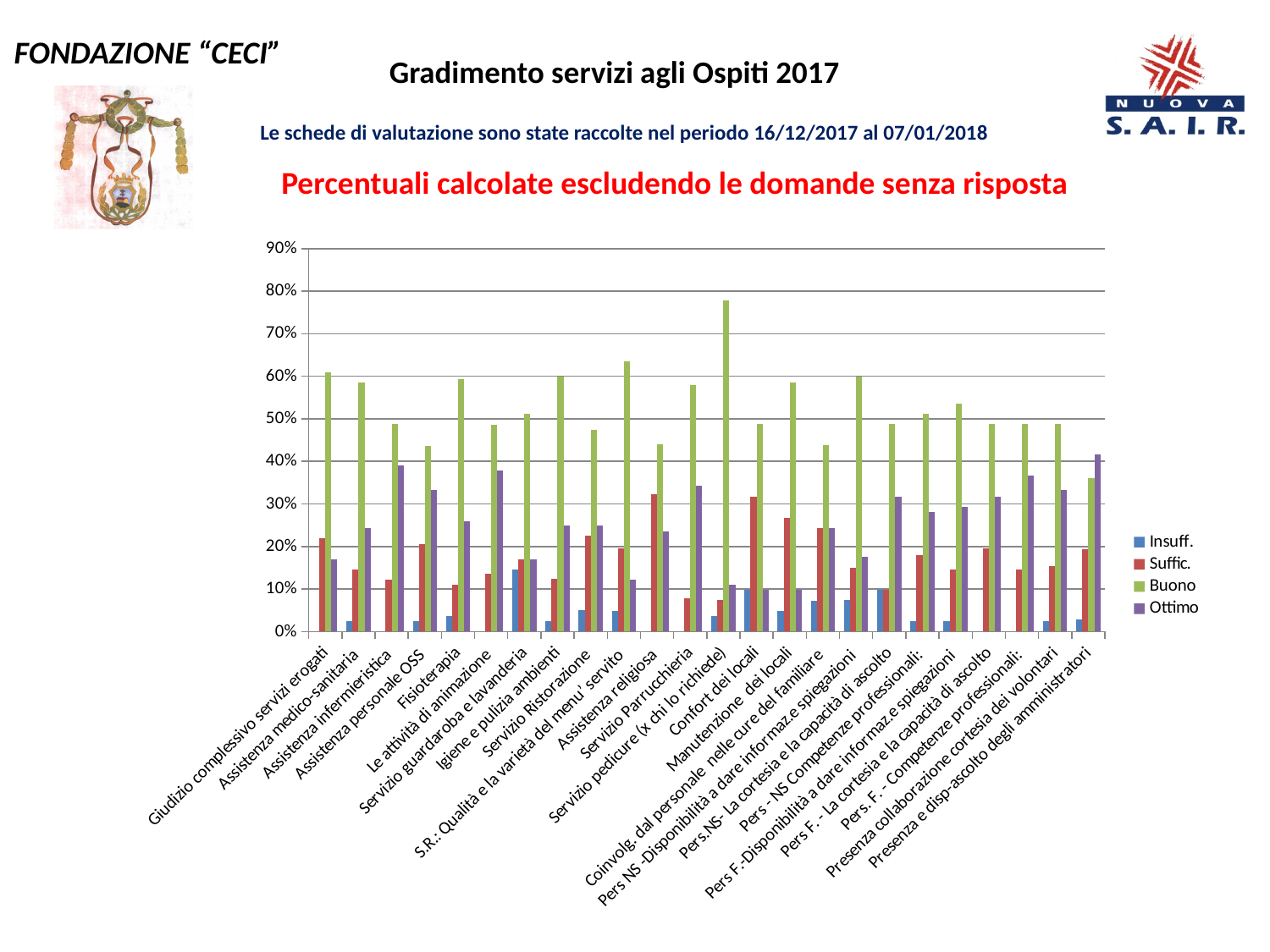
For Servizio Parrucchieria, which is larger: the Suffic. value or the Ottimo value? Ottimo Is the Buono value for Giudizio complessivo servizi erogati greater or less than 50%? greater For Assistenza infermieristica, which is larger: the Buono value or the Ottimo value? Buono Which category has the highest Buono value? Servizio pedicure (x chi lo richiede) How many series does the legend list? 4 Is the Ottimo value for Presenza e disp-ascolto degli amministratori greater or less than 30%? greater Is the Buono value for Servizio pedicure (x chi lo richiede) greater or less than 70%? greater What kind of chart is shown on the slide? Bar chart Which colour represents the Buono series in the legend? Green How many categories are shown along the x axis? 24